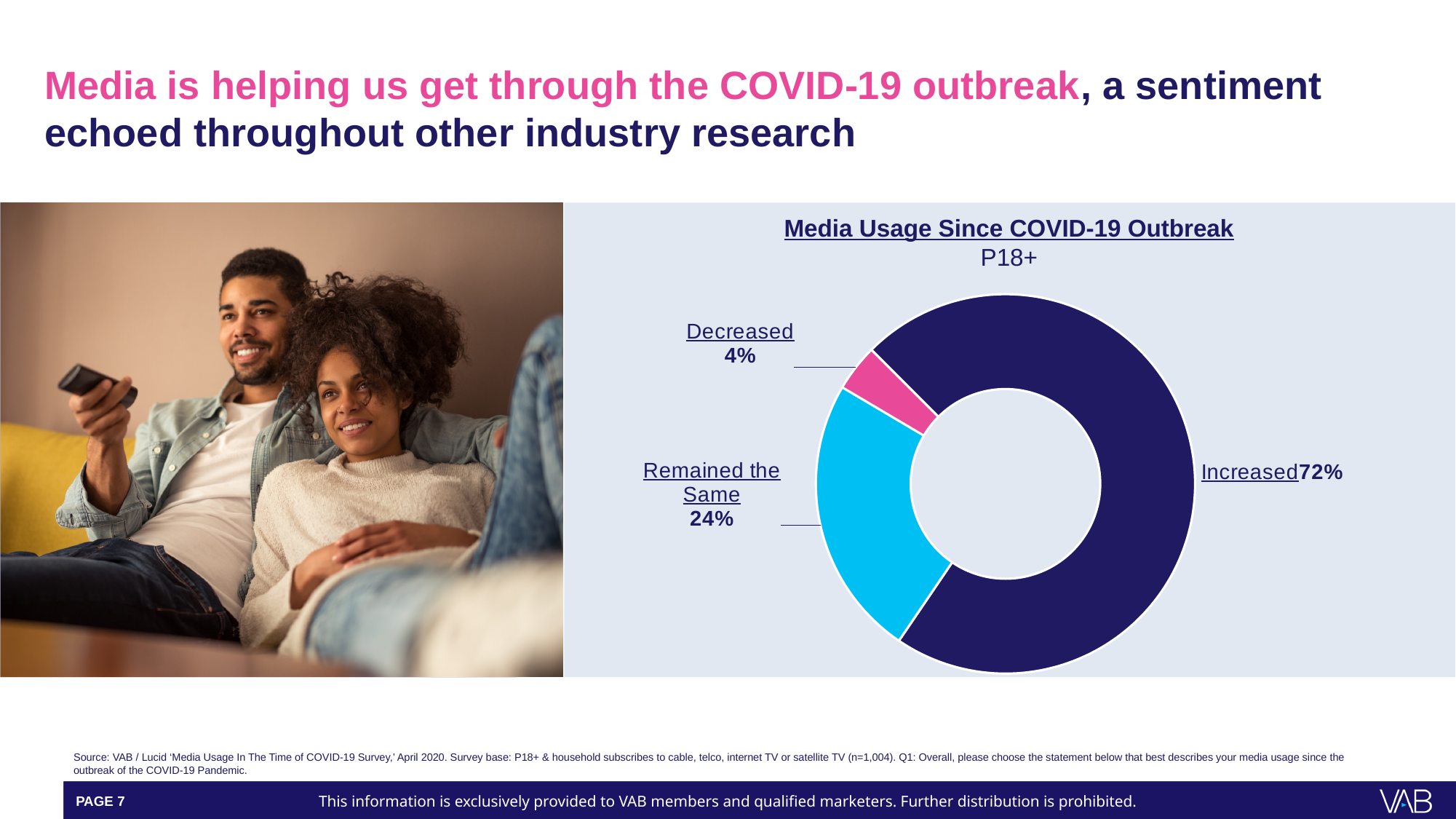
What is the difference in percentage points between Remained the Same and Decreased? 20 What percentage of respondents said their media usage increased since the COVID-19 outbreak? 72% What kind of chart is shown on the slide? Doughnut (pie) chart What colour is the Decreased slice of the chart? Pink How many categories are shown in the chart? 3 Which is larger, the share for Remained the Same or the share for Decreased? Remained the Same What percentage of respondents said their media usage decreased? 4% Which category has the smallest share of the chart? Decreased What is the difference in percentage points between Increased and Remained the Same? 48 What is the title of the chart? Media Usage Since COVID-19 Outbreak Which category has the largest share of the chart? Increased What percentage of respondents said their media usage remained the same? 24%